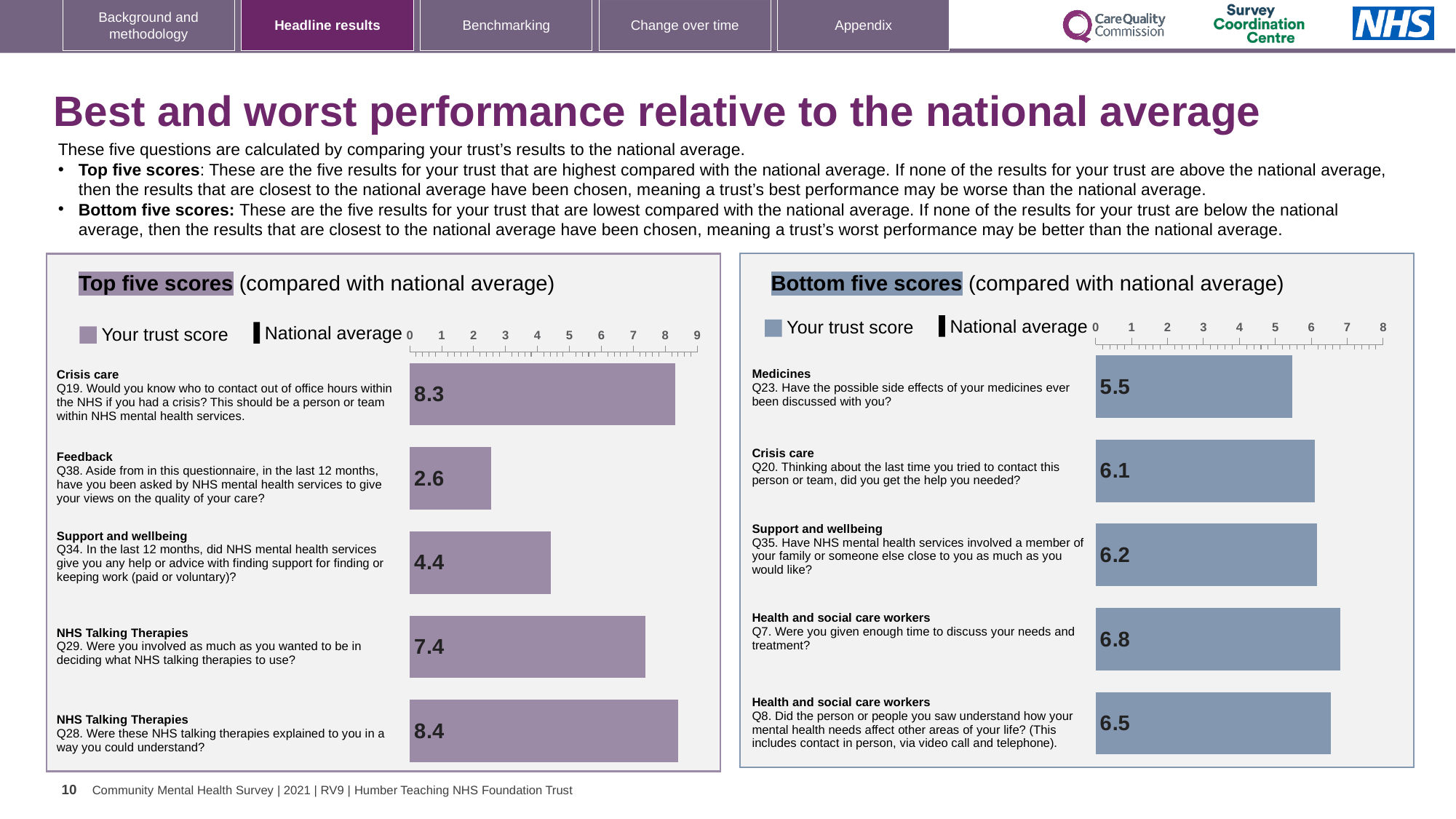
How many bars are plotted in the Bottom five scores chart? 5 In the Bottom five scores chart, what is the trust score for Q8 (Health and social care workers)? 6.5 In the Bottom five scores chart, what is the trust score for Q23 (Medicines)? 5.5 In the Top five scores chart, which question has the lowest trust score? Q38 (Feedback) In the Top five scores chart, which question has the highest trust score? Q28 (NHS Talking Therapies) In the Bottom five scores chart, which has the larger trust score, Q20 (Crisis care) or Q35 (Support and wellbeing)? Q35 (Support and wellbeing) In the Bottom five scores chart, which question has the highest trust score? Q7 (Health and social care workers) In the Top five scores chart, what is the trust score for Q19 (Crisis care)? 8.3 What type of chart is used in the Top five scores panel? Bar chart In the Top five scores chart, what is the trust score for Q38 (Feedback)? 2.6 In the Top five scores chart, what is the difference between the trust scores for Q29 and Q34? 3.0 In the Bottom five scores chart, which question has the lowest trust score? Q23 (Medicines)